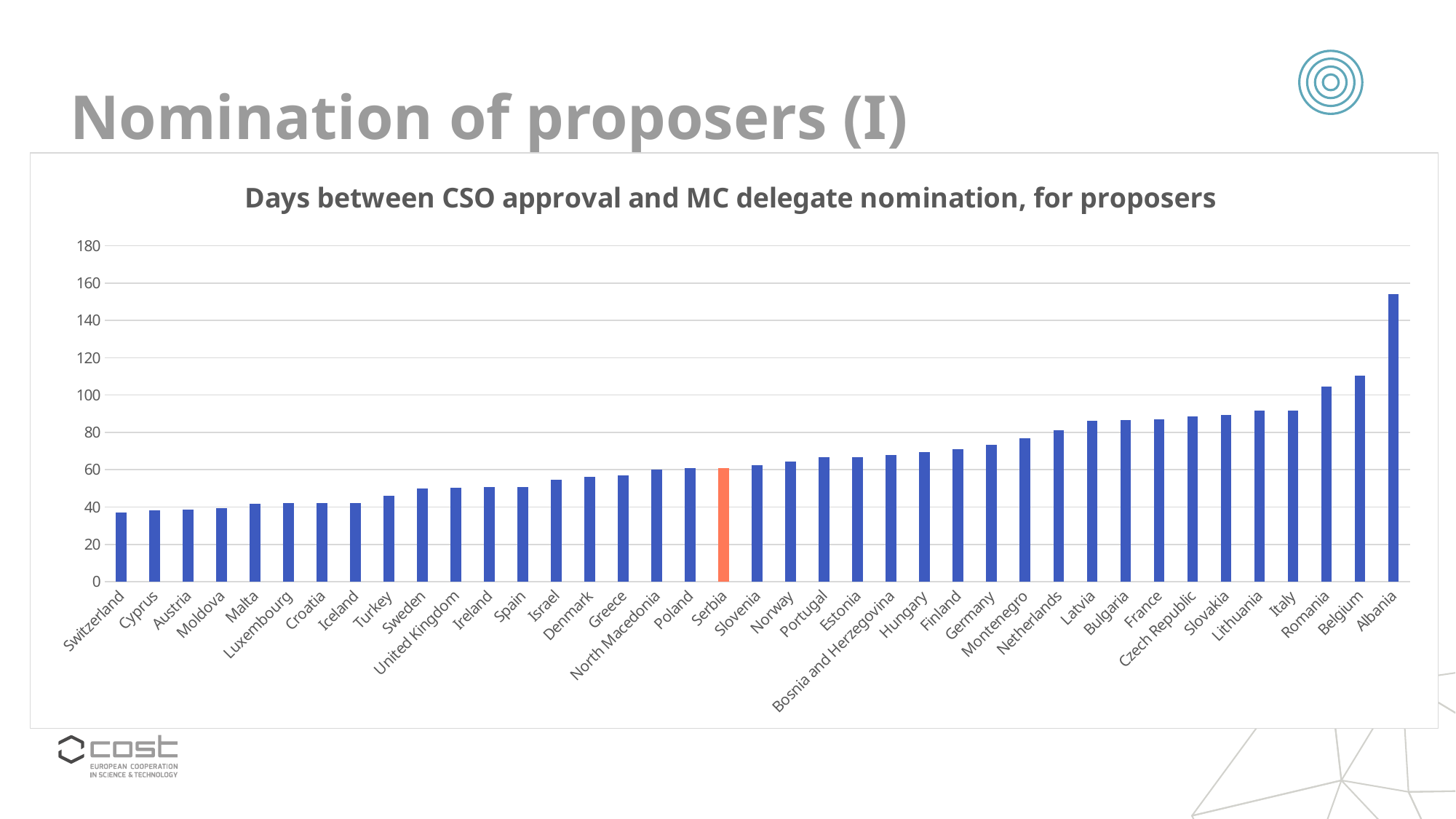
What is the title of the chart? Days between CSO approval and MC delegate nomination, for proposers Which country's bar is highlighted in orange rather than blue? Serbia Do the values generally rise or fall moving from left to right along the x axis? Rise Is the value for Albania greater or less than 140? greater Is the value for Latvia greater or less than 80? greater Is the value for Switzerland greater or less than 40? less How many countries are shown on the x axis of the chart? 39 Which has a larger value, Belgium or Albania? Albania What type of chart is shown on the slide? Bar chart Which country has the highest number of days between CSO approval and MC delegate nomination? Albania